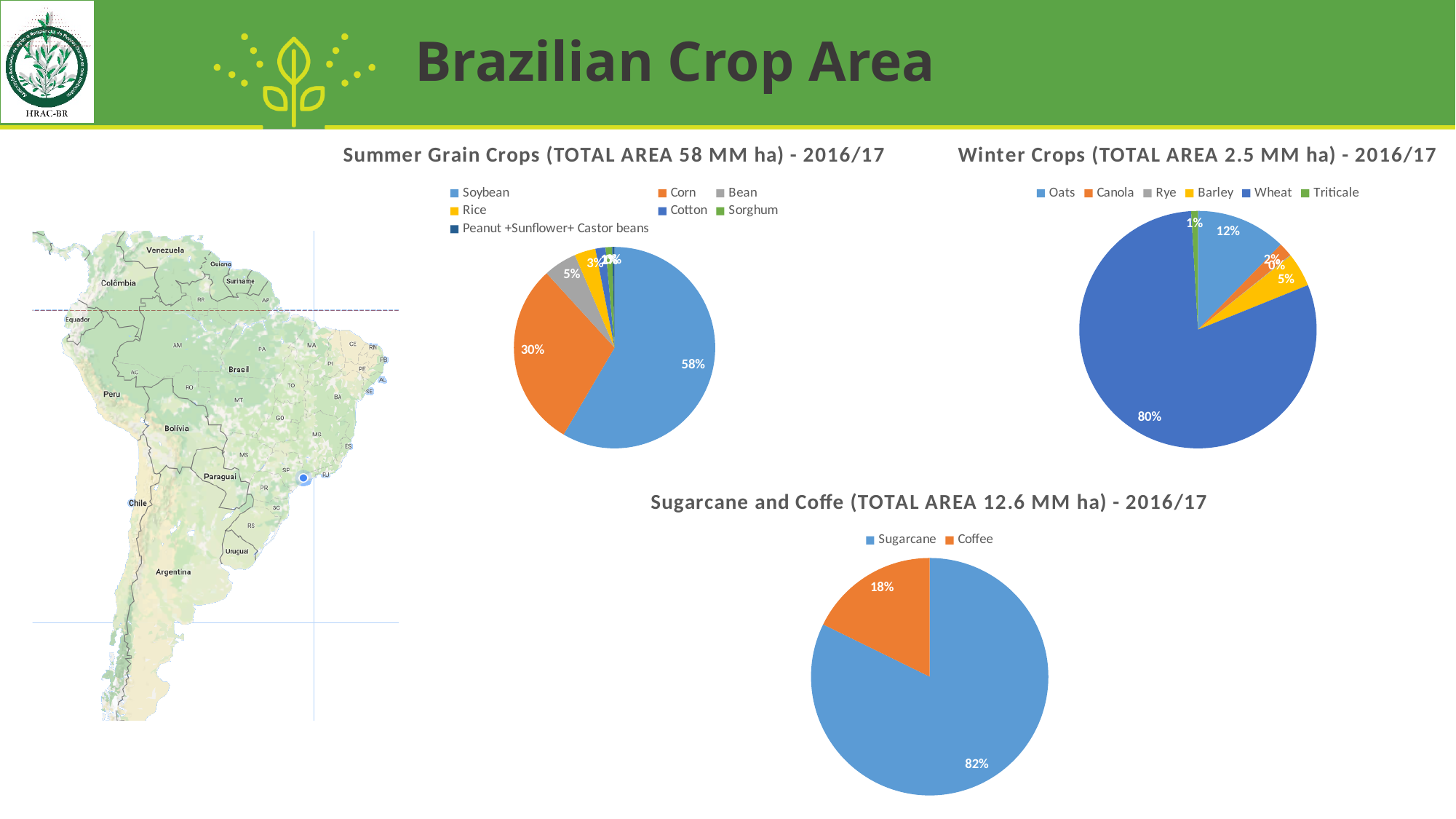
In the Summer Grain Crops chart, what share of the area is Corn? 30% In the Winter Crops chart, what share of the area is Oats? 12% How many entries does the legend of the Summer Grain Crops chart list? 7 In the Summer Grain Crops chart, which crop has the largest share? Soybean In the Sugarcane and Coffe chart, what share of the area is Coffee? 18% In the Winter Crops chart, which is larger, the Oats share or the Barley share? Oats In the Summer Grain Crops chart, what share of the area is Soybean? 58% How many entries does the legend of the Winter Crops chart list? 6 What type of chart is the Sugarcane and Coffe chart? Pie chart What total area is stated in the title of the Winter Crops chart? 2.5 MM ha In the Summer Grain Crops chart, what is the difference between the Soybean and Corn shares? 28% In the Winter Crops chart, what share of the area is Wheat? 80%